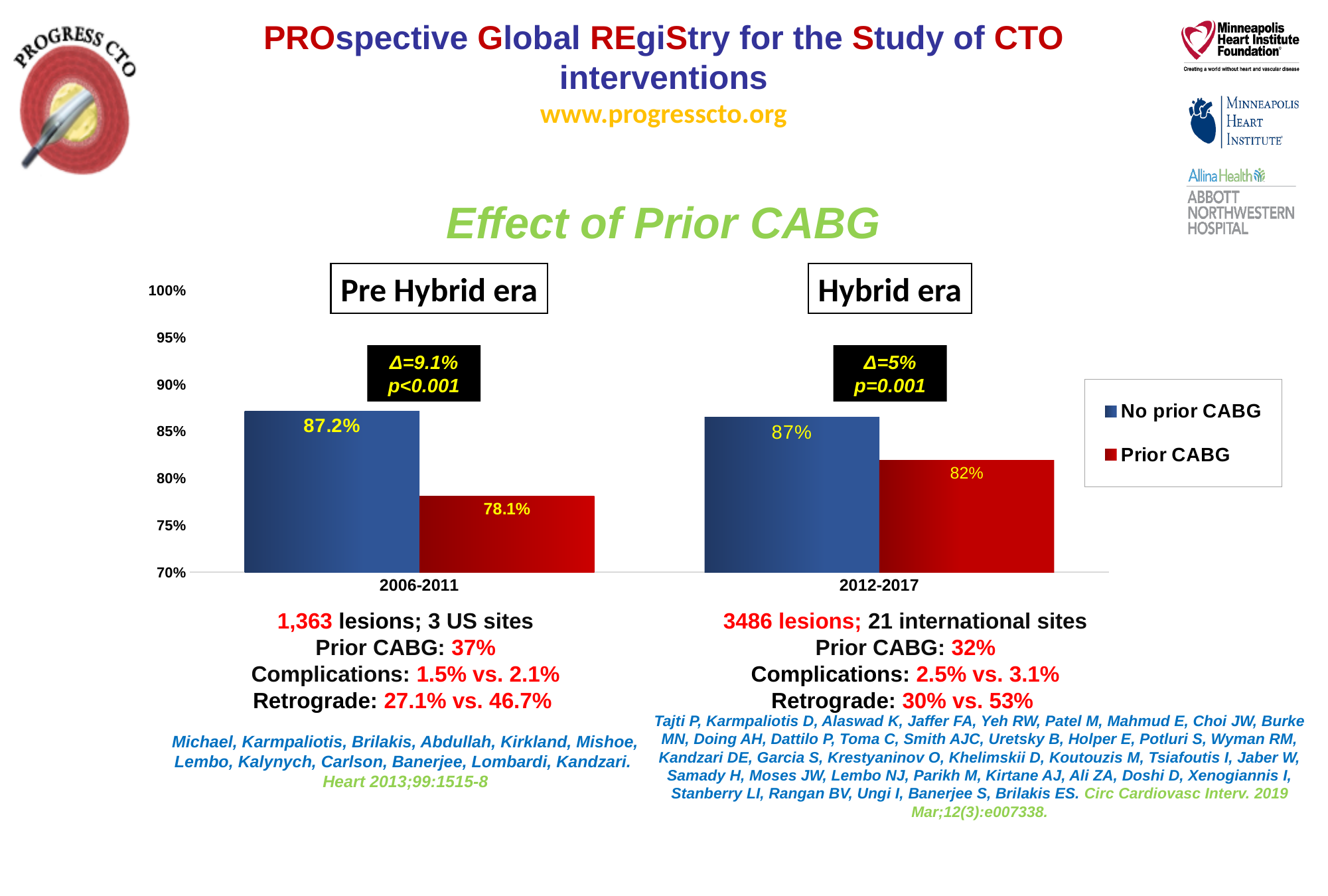
How many categories are shown on the x axis? 2 How many series does the legend list? 2 What is the value for Prior CABG in 2006-2011? 78.1% What is the difference between No prior CABG and Prior CABG in 2012-2017? 5% Which bar has the lowest value on the chart? Prior CABG in 2006-2011 Is the value for Prior CABG in 2006-2011 greater or less than 80%? less What is the value for Prior CABG in 2012-2017? 82% What kind of chart is shown on the slide? bar chart Which is larger in 2006-2011, No prior CABG or Prior CABG? No prior CABG What is the value for No prior CABG in 2006-2011? 87.2% What is the value for No prior CABG in 2012-2017? 87% Which colour represents Prior CABG in the legend? red